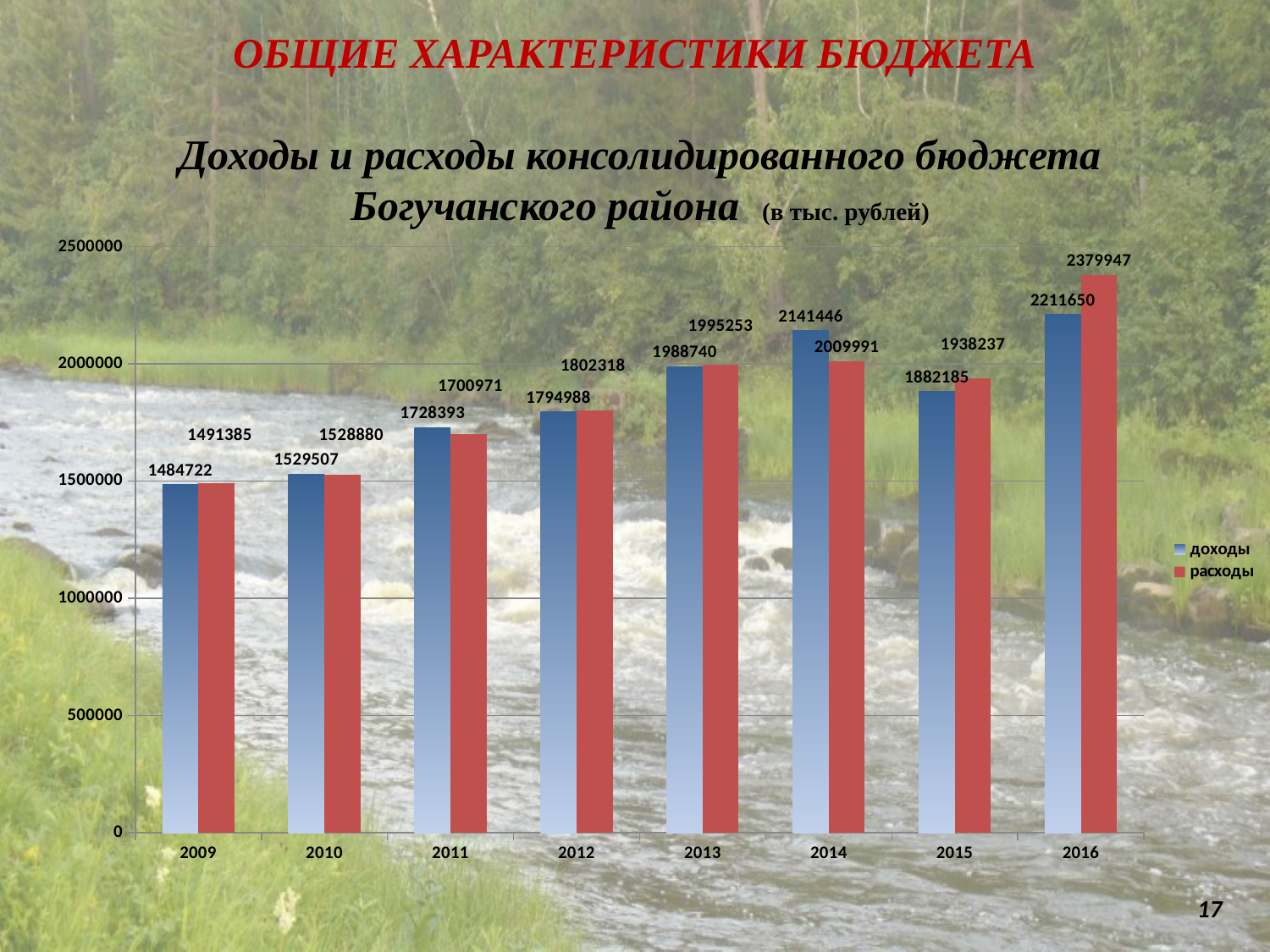
What is the value of доходы for 2014? 2141446 How many series does the legend list? 2 In 2014, which is larger: доходы or расходы? доходы What is the difference between доходы and расходы in 2014? 131455 What is the value of расходы for 2011? 1700971 In which year are доходы the lowest? 2009 How many years are shown on the x axis? 8 Is the value of доходы for 2014 greater or less than 2000000? greater What is the difference between расходы and доходы in 2016? 168297 What is the value of расходы for 2016? 2379947 What kind of chart is shown on the slide? bar chart In which year are расходы the highest? 2016